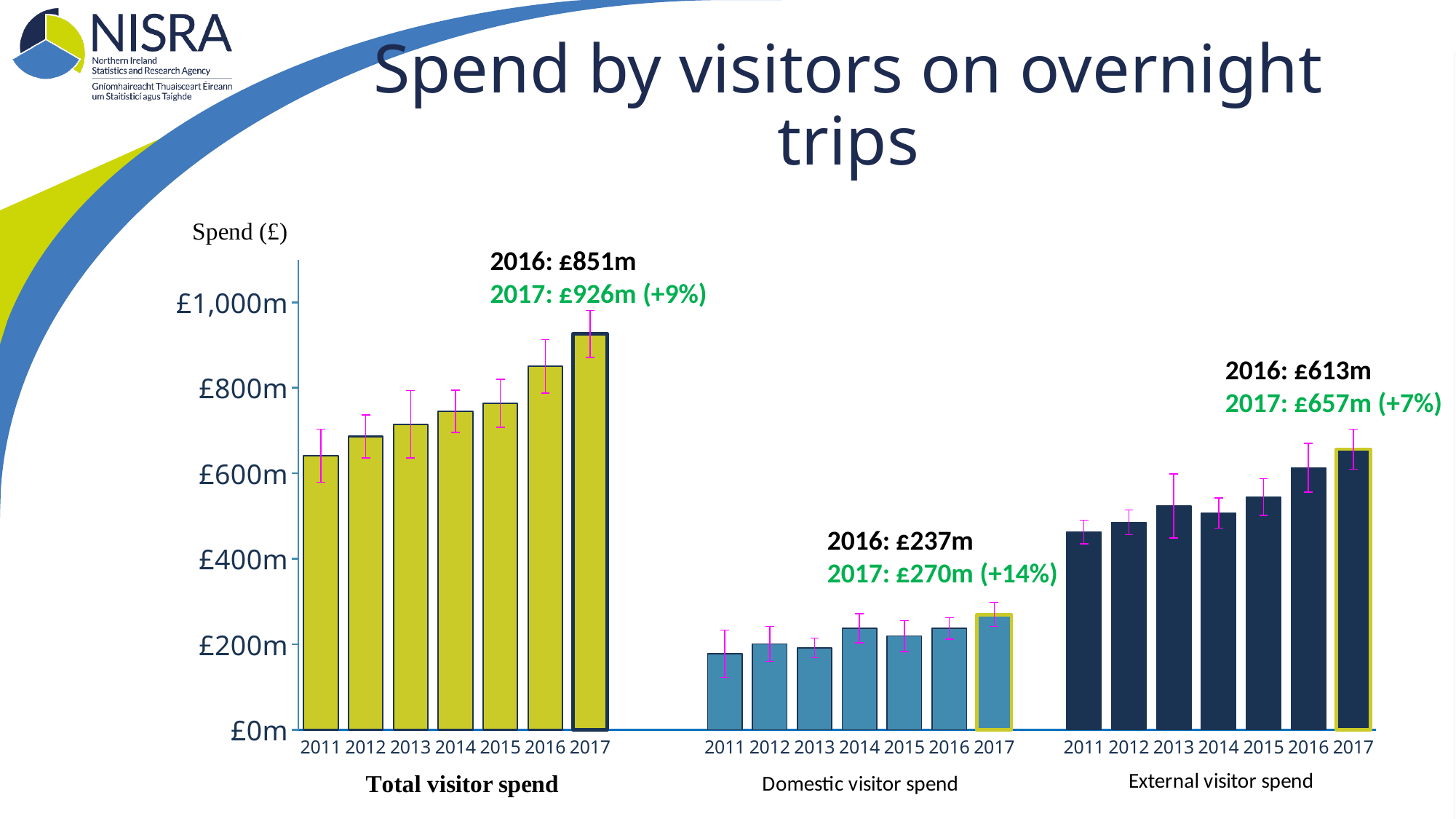
What is the difference between external visitor spend in 2017 and 2016? £44m How many years are plotted in each group of bars? 7 Which year has the highest total visitor spend? 2017 Is the total visitor spend for 2011 greater or less than £600m? greater Is the domestic visitor spend for 2011 greater or less than £200m? less What was the total visitor spend in 2017? £926m What percentage change in domestic visitor spend from 2016 to 2017 is shown on the slide? +14% What was the domestic visitor spend in 2016? £237m What kind of chart is shown on the slide? Bar chart What is the difference between domestic visitor spend in 2017 and 2016? £33m By how much did total visitor spend increase from 2016 to 2017? £75m What was the external visitor spend in 2017? £657m